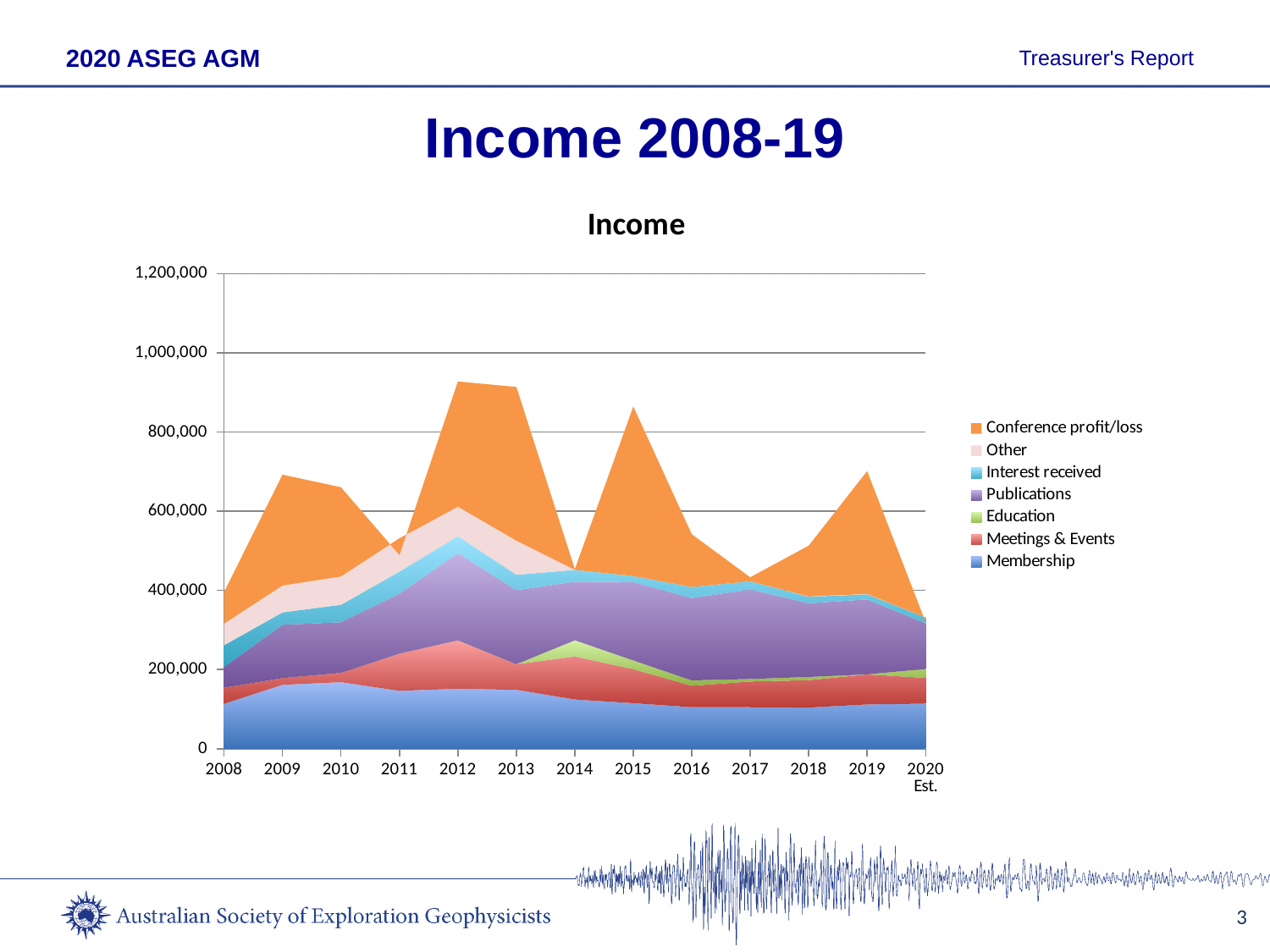
How many years (points) are shown along the x axis? 13 Is the total income in 2014 greater or less than 600,000? less Is the total income in 2009 greater or less than 600,000? greater What kind of chart is shown on the slide? Stacked area chart Which year has the larger total income, 2009 or 2017? 2009 Which year has the highest total income? 2012 How many series does the legend list? 7 What is the title of the chart? Income Which series is plotted at the bottom of the stack? Membership Is the total income in 2012 greater or less than 800,000? greater Which year has the lowest total income? 2020 Est.